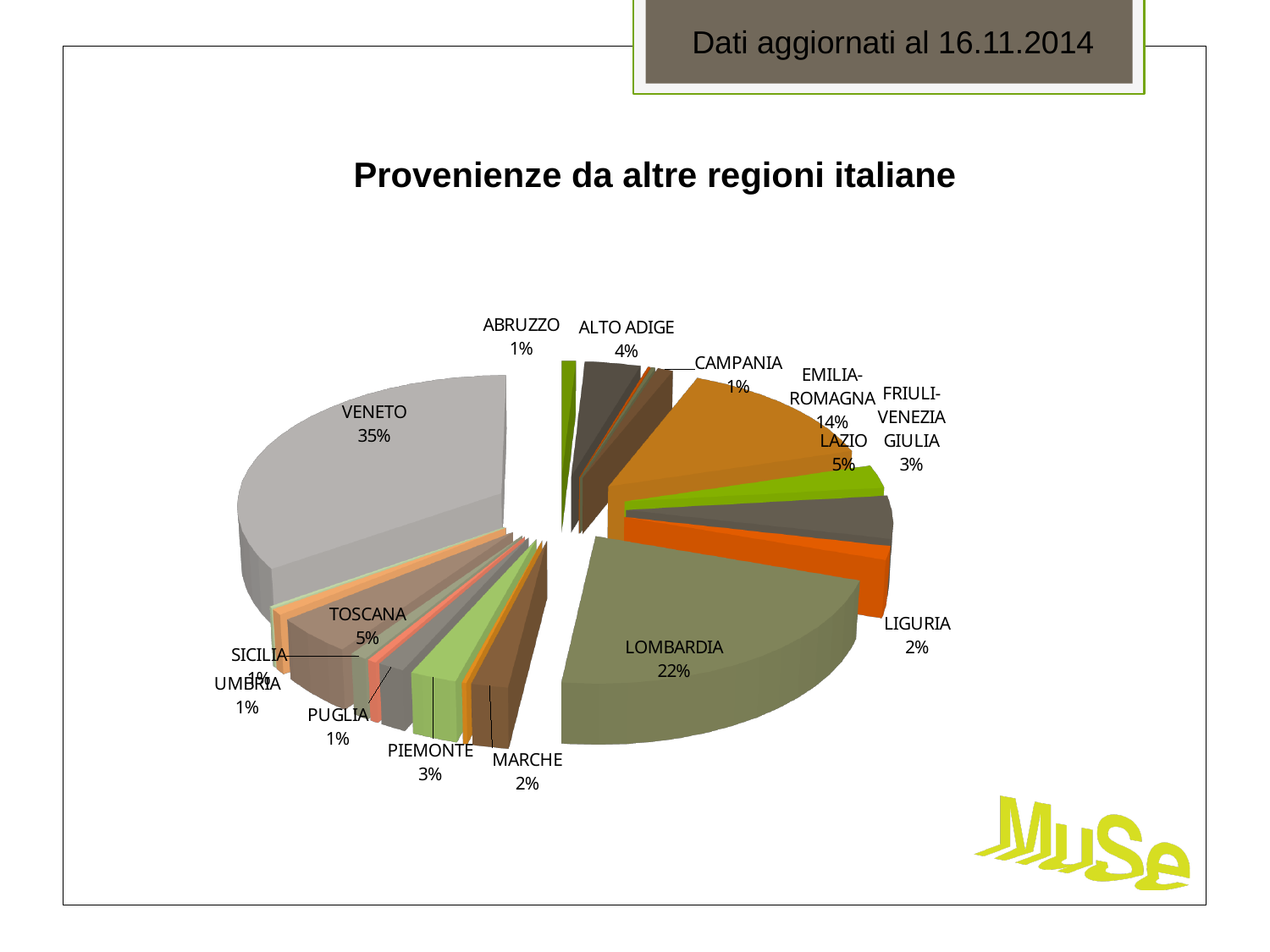
What percentage is shown for ALTO ADIGE? 4% Which is larger, the share for LAZIO or the share for PIEMONTE? LAZIO What is the title of the chart? Provenienze da altre regioni italiane What percentage is shown for LOMBARDIA? 22% What percentage is shown for TOSCANA? 5% Which region has the largest slice of the pie? VENETO What kind of chart is shown on the slide? Pie chart Which is larger, the share for EMILIA-ROMAGNA or the share for ALTO ADIGE? EMILIA-ROMAGNA What share of the pie does VENETO represent? 35% What is the difference in percentage points between VENETO and LOMBARDIA? 13 What is the value labelled for EMILIA-ROMAGNA? 14%